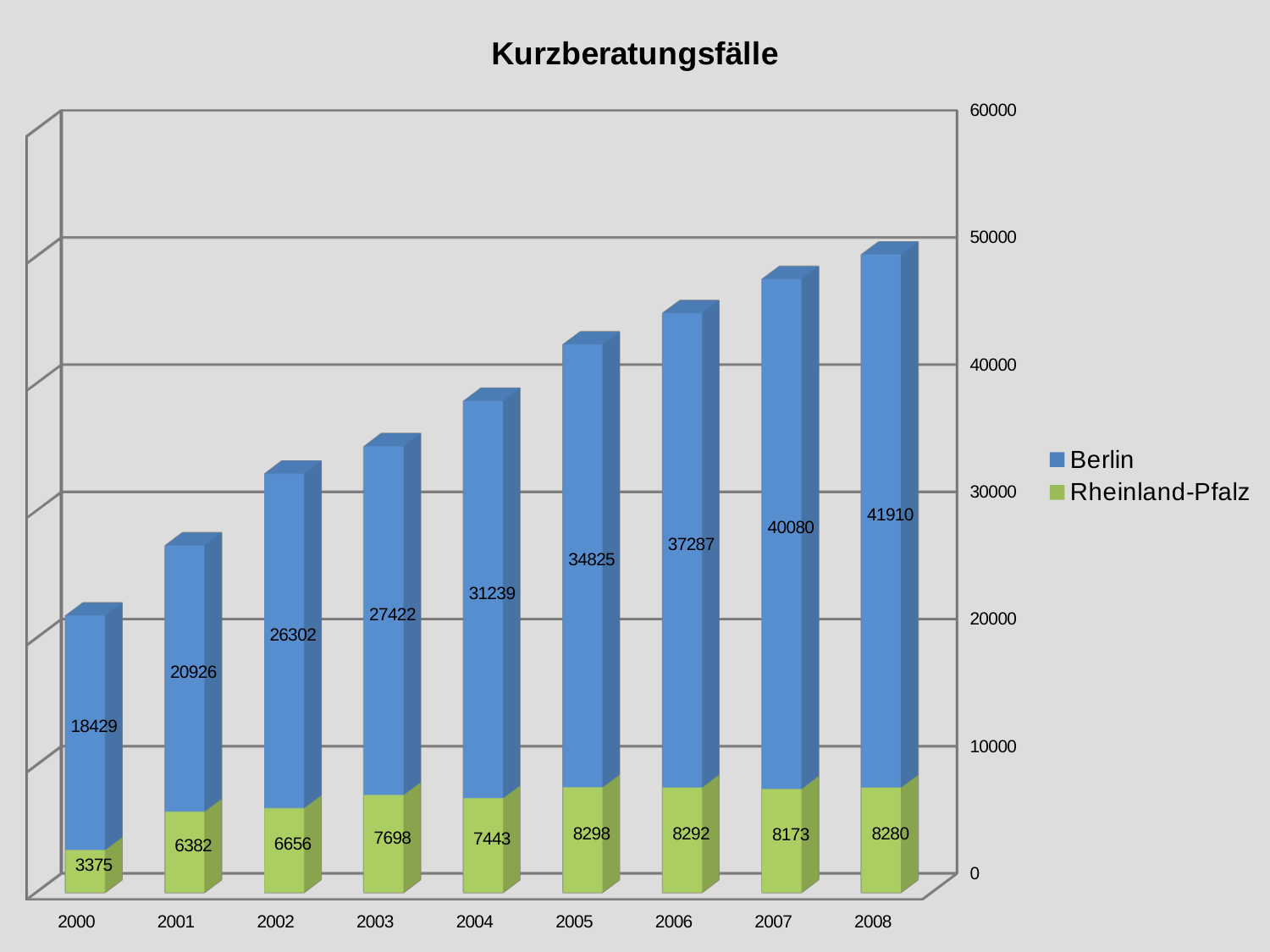
Do the Berlin values rise or fall from 2000 to 2008? rise What is the total of the stacked bar for 2000? 21804 Is the total stacked bar for 2006 greater or less than 40000? greater How many series does the legend list? 2 What is the value for Rheinland-Pfalz in 2003? 7698 What kind of chart is shown? stacked bar chart In which year is the Berlin value highest? 2008 What is the value for Berlin in 2005? 34825 How many years are shown on the x axis? 9 In which year is the Rheinland-Pfalz value lowest? 2000 Which is larger, the Rheinland-Pfalz value for 2003 or for 2004? 2003 What is the difference between the Berlin values for 2008 and 2007? 1830